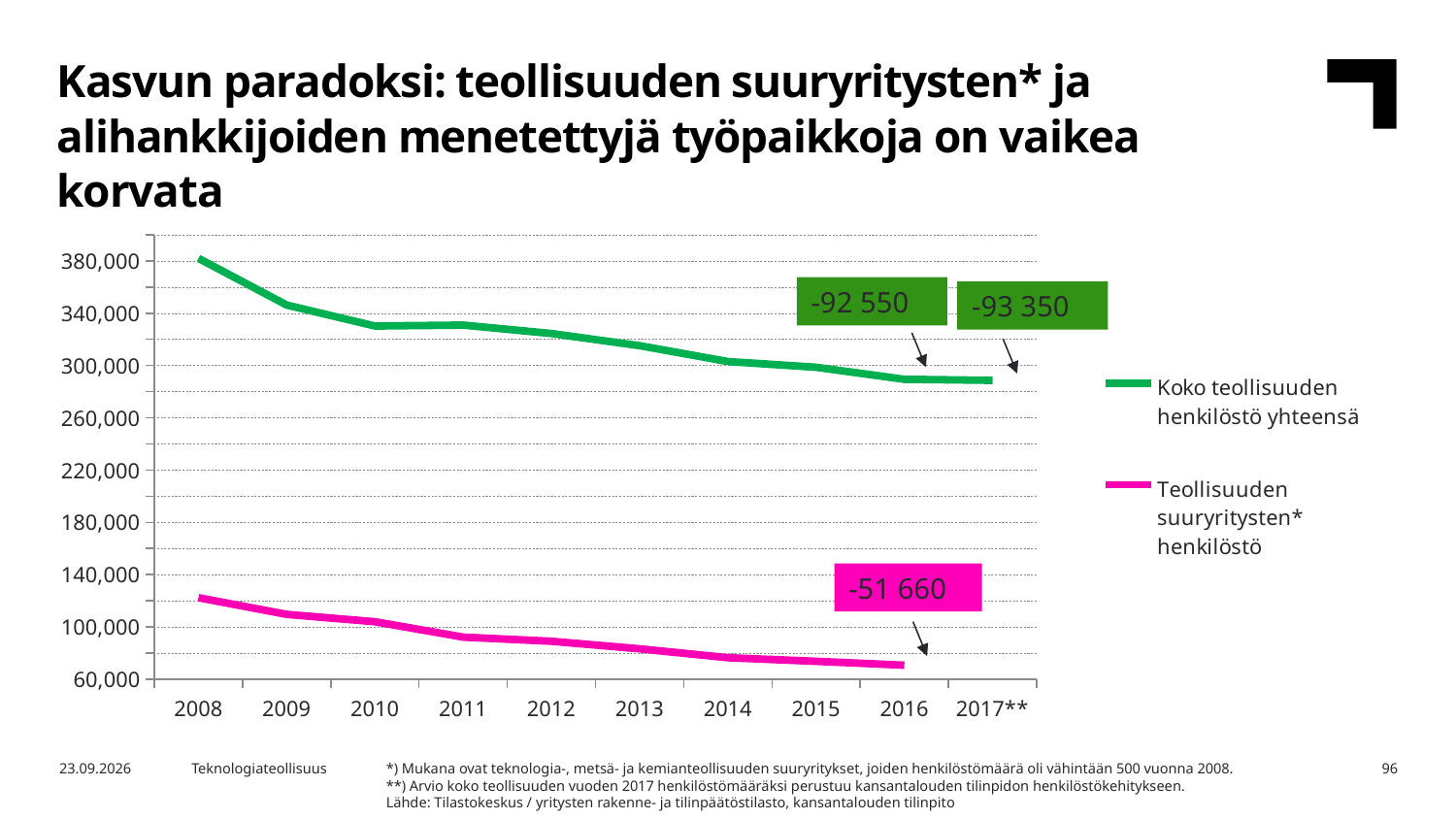
Is the value for Koko teollisuuden henkilöstö yhteensä in 2016 greater or less than 300,000? less Is the value for Koko teollisuuden henkilöstö yhteensä in 2010 greater or less than 340,000? less How many years are shown on the x axis? 10 Is the value for Teollisuuden suuryritysten henkilöstö in 2008 greater or less than 100,000? greater Does the value for Koko teollisuuden henkilöstö yhteensä rise or fall from 2008 to 2016? fall What change is shown in the annotation box pointing to the 2016 value of Teollisuuden suuryritysten henkilöstö? -51 660 What kind of chart is shown on the slide? line chart Does the value for Teollisuuden suuryritysten henkilöstö rise or fall from 2008 to 2016? fall What colour is the line for Koko teollisuuden henkilöstö yhteensä? green How many series does the legend list? 2 In 2012, which series has the larger value: Koko teollisuuden henkilöstö yhteensä or Teollisuuden suuryritysten henkilöstö? Koko teollisuuden henkilöstö yhteensä